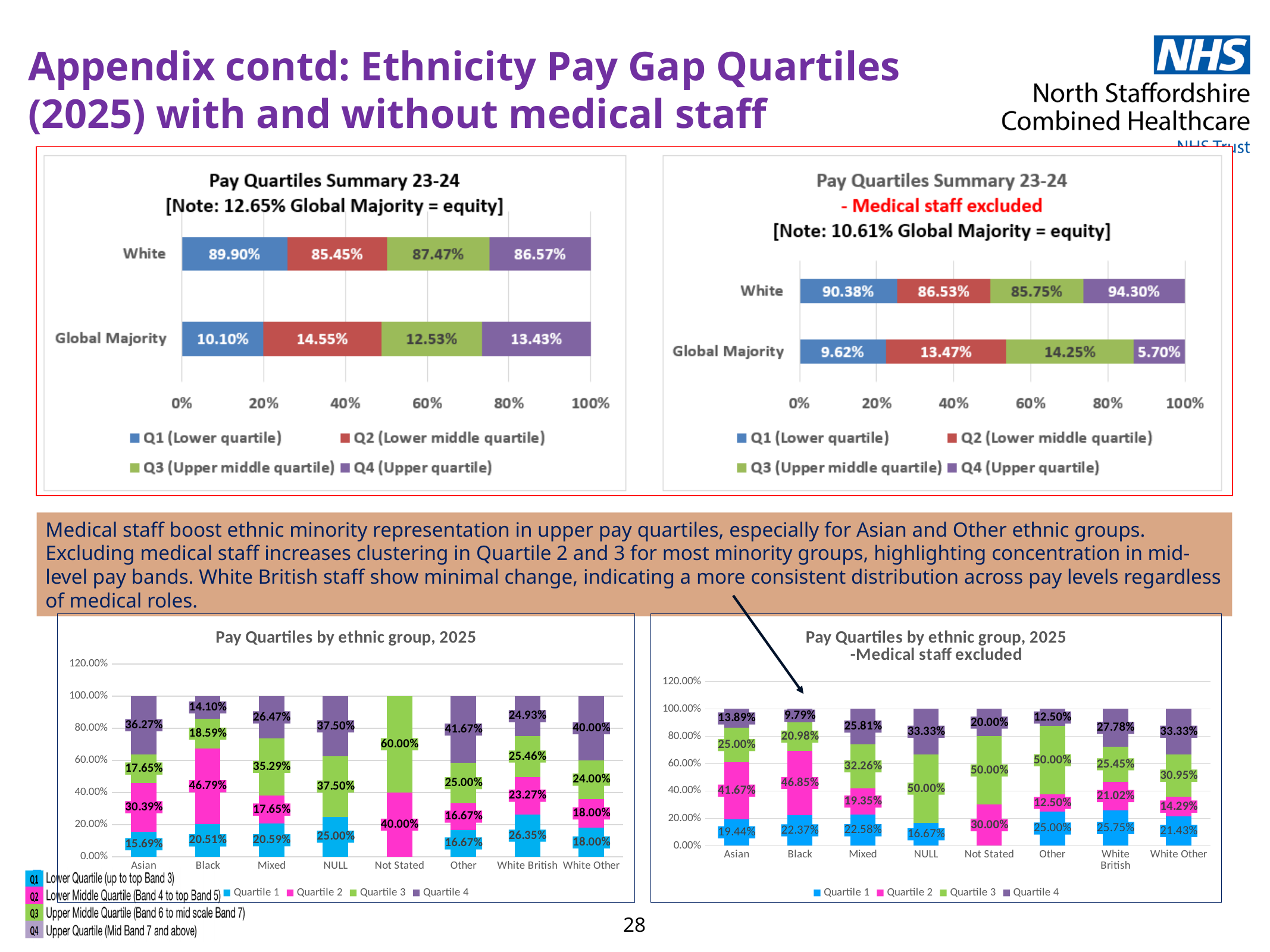
What type of chart is the bottom-left chart 'Pay Quartiles by ethnic group, 2025'? Stacked bar chart In the top-right chart 'Pay Quartiles Summary 23-24 - Medical staff excluded', what is the Q4 (Upper quartile) value for Global Majority? 5.70% How many series does the legend list in the top-left chart 'Pay Quartiles Summary 23-24'? 4 In the top-right chart 'Pay Quartiles Summary 23-24 - Medical staff excluded', what is the difference between the Q2 values for White and Global Majority? 73.06% How many ethnic group categories are shown on the x axis of the bottom-left chart 'Pay Quartiles by ethnic group, 2025'? 8 In the bottom-left chart 'Pay Quartiles by ethnic group, 2025', which ethnic group has the highest Quartile 4 value? Other In the bottom-right chart 'Pay Quartiles by ethnic group, 2025 - Medical staff excluded', is the Quartile 4 value for Asian or for White Other larger? White Other In the top-right chart 'Pay Quartiles Summary 23-24 - Medical staff excluded', which quartile has the highest value for White? Q4 (Upper quartile) In the bottom-right chart 'Pay Quartiles by ethnic group, 2025 - Medical staff excluded', what is the Quartile 3 value for Other? 50.00% In the bottom-left chart 'Pay Quartiles by ethnic group, 2025', what is the Quartile 2 value for Black? 46.79% In the top-left chart 'Pay Quartiles Summary 23-24', what is the Q3 (Upper middle quartile) value for White? 87.47% In the top-left chart 'Pay Quartiles Summary 23-24', what is the Q1 (Lower quartile) value for Global Majority? 10.10%